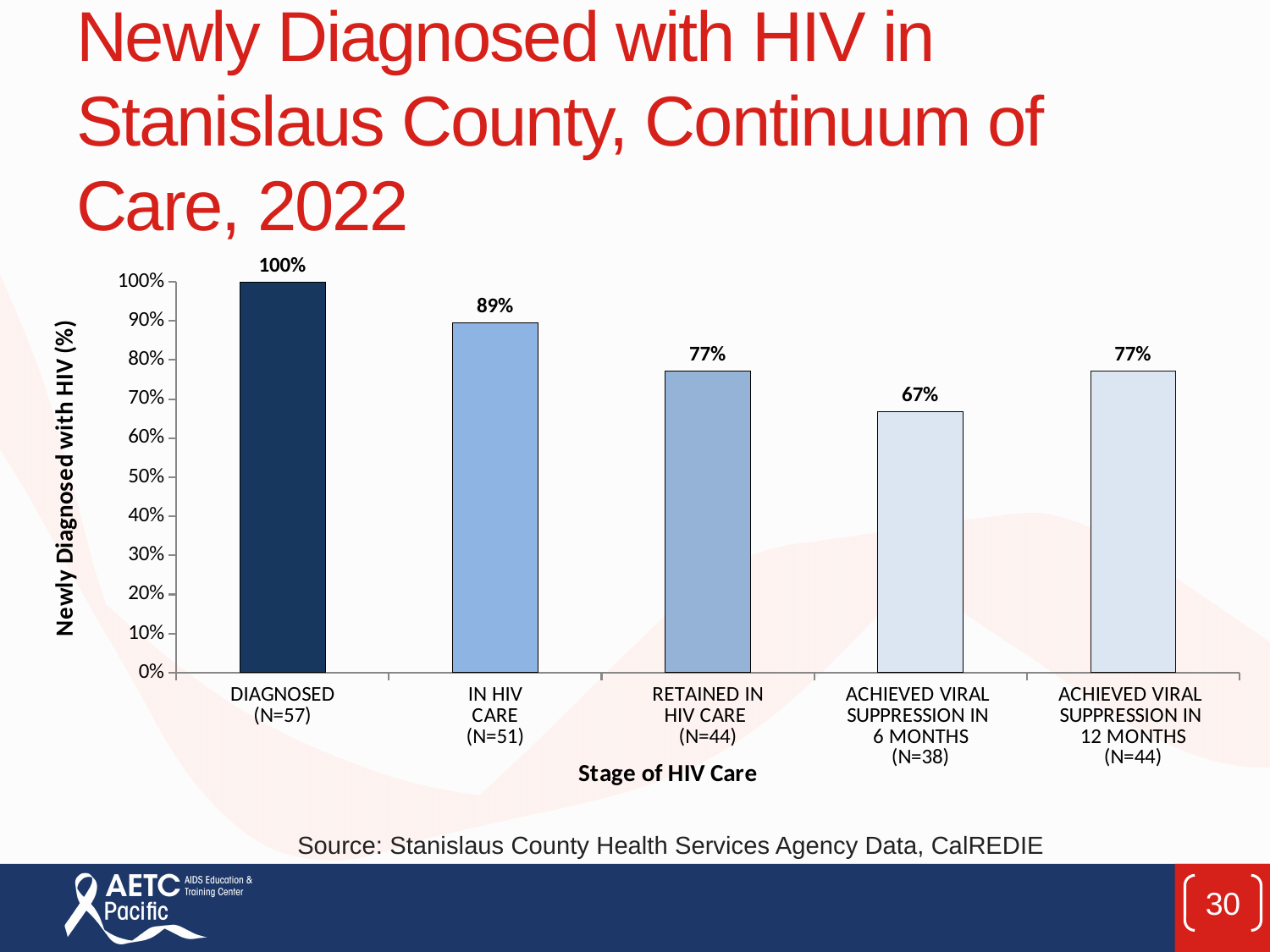
What kind of chart is shown on the slide? Bar chart What is the difference in percentage points between Diagnosed and In HIV Care? 11 What is the value for Achieved Viral Suppression in 12 Months? 77% What is the difference in percentage points between Achieved Viral Suppression in 12 Months and Achieved Viral Suppression in 6 Months? 10 Which stage of HIV care has the highest percentage? Diagnosed What is the value for Retained in HIV Care? 77% What percentage achieved viral suppression in 6 months? 67% What percentage of newly diagnosed people were in HIV care? 89% How many stages of HIV care are shown on the x axis? 5 Which is larger, the value for In HIV Care or the value for Retained in HIV Care? In HIV Care Which stage of HIV care has the lowest percentage? Achieved Viral Suppression in 6 Months What is the N value shown for the Diagnosed category? N=57